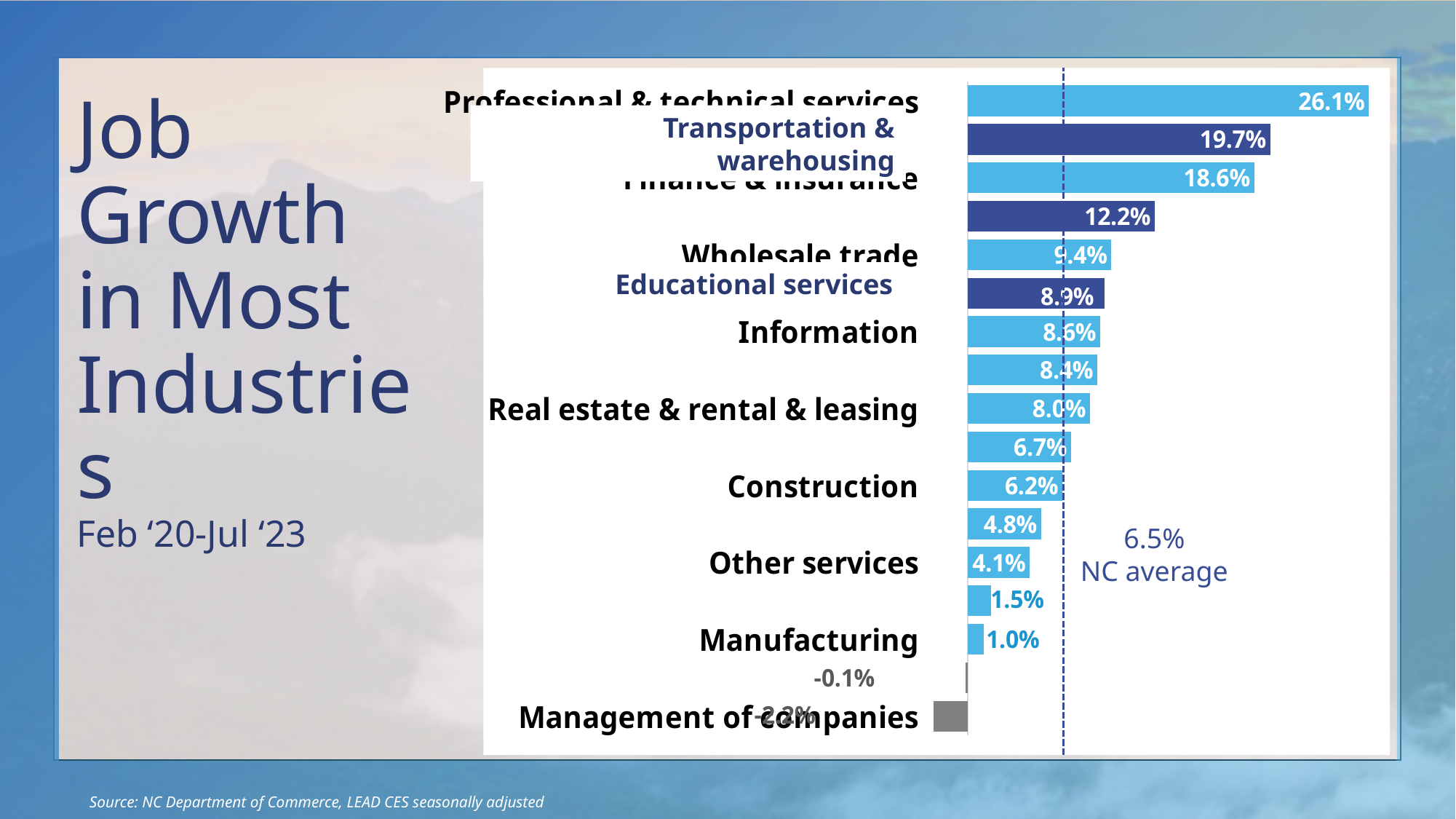
What is the job growth value for Construction? 6.2% What is the job growth value for Educational services? 8.9% What kind of chart is shown on the slide? Bar chart Which industry has the highest job growth? Professional & technical services What is the NC average job growth marked by the dashed line? 6.5% What is the job growth value for Manufacturing? 1.0% What is the job growth value for Professional & technical services? 26.1% What is the job growth value for Transportation & warehousing? 19.7% Which industry has the lowest job growth? Management of companies What is the difference in job growth between Professional & technical services and Transportation & warehousing? 6.4 percentage points Which has higher job growth, Construction or Other services? Construction What is the job growth value for Wholesale trade? 9.4%